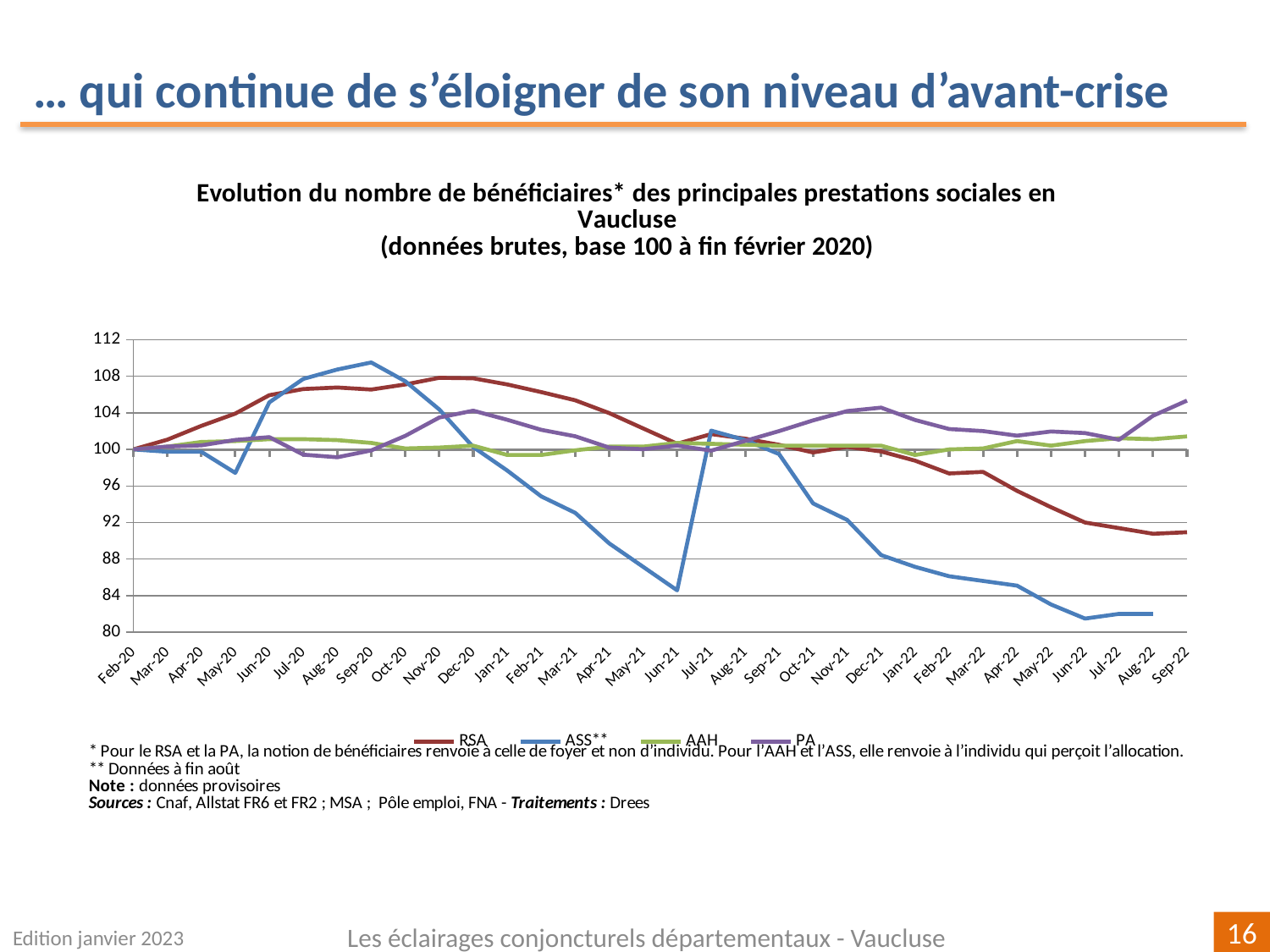
Is the value for ASS** in Jun-21 greater or less than 88? less How many series does the legend list? 4 Is the value for RSA in Sep-22 greater or less than 96? less How many monthly points are shown on the x axis, from Feb-20 to Sep-22? 32 Does the ASS** series rise or fall between Jul-21 and Aug-22? fall In Jun-21, which is larger, the value for RSA or the value for ASS**? RSA What kind of chart is shown on the slide? line chart Is the value for ASS** in Sep-20 greater or less than 108? greater Which series are listed in the legend? RSA, ASS**, AAH, PA Which series has the lowest value in Aug-22? ASS** Which series has the highest value in Sep-22? PA